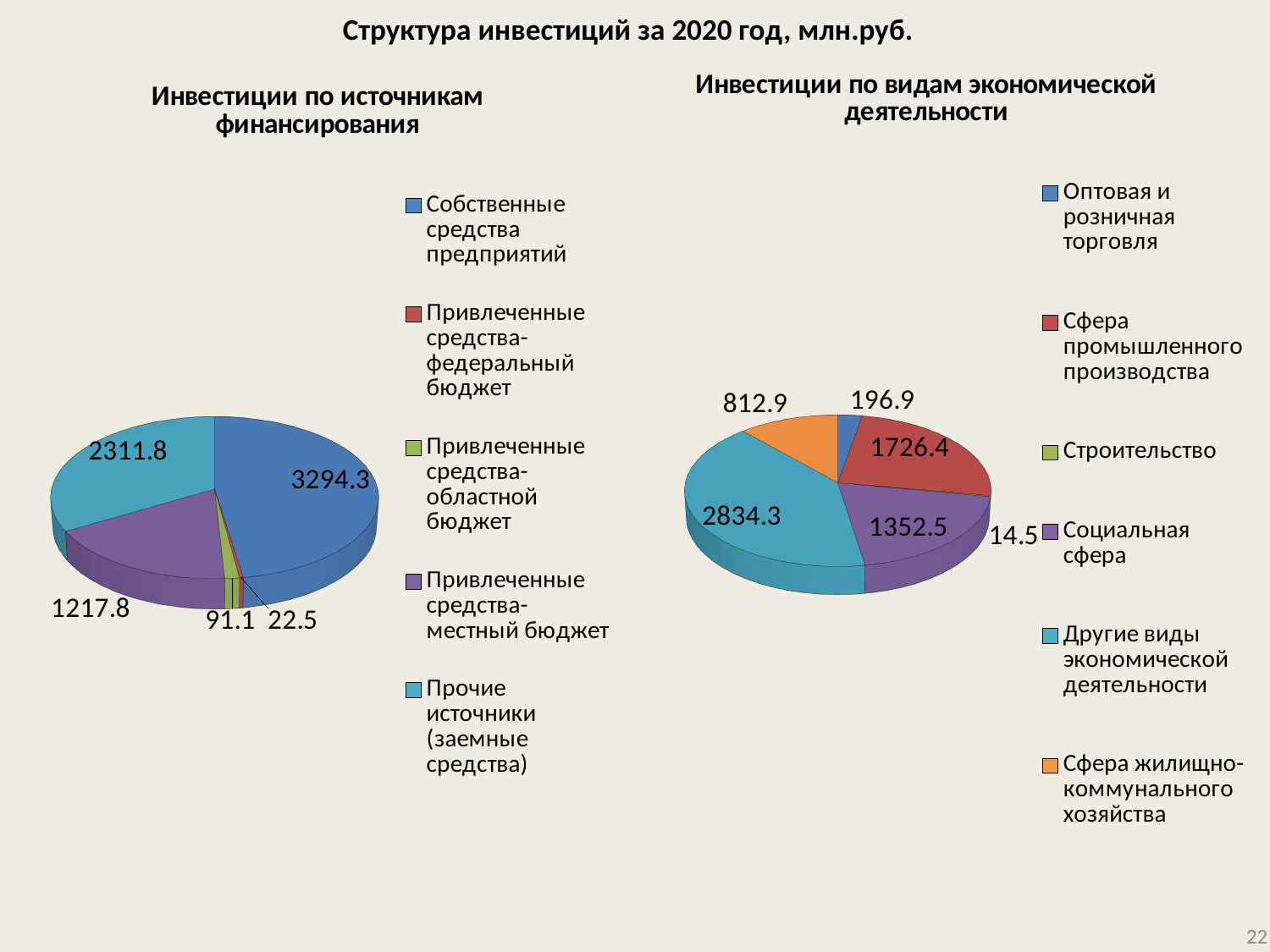
On the left pie chart (Инвестиции по источникам финансирования), what is the value for Привлеченные средства-местный бюджет? 1217.8 On the right pie chart (Инвестиции по видам экономической деятельности), what is the value for Строительство? 14.5 On the right pie chart (Инвестиции по видам экономической деятельности), what is the difference between Другие виды экономической деятельности and Сфера промышленного производства? 1107.9 On the left pie chart (Инвестиции по источникам финансирования), what is the value for Собственные средства предприятий? 3294.3 On the right pie chart (Инвестиции по видам экономической деятельности), how many categories does the legend list? 6 What type of chart is used for both charts on the slide? Pie chart On the left pie chart (Инвестиции по источникам финансирования), which source has the smallest value? Привлеченные средства-федеральный бюджет On the right pie chart (Инвестиции по видам экономической деятельности), which category has the largest value? Другие виды экономической деятельности On the right pie chart (Инвестиции по видам экономической деятельности), what is the value for Сфера промышленного производства? 1726.4 On the left pie chart (Инвестиции по источникам финансирования), how many slices does the pie have? 5 On the left pie chart (Инвестиции по источникам финансирования), what is the difference between Собственные средства предприятий and Прочие источники (заемные средства)? 982.5 On the right pie chart (Инвестиции по видам экономической деятельности), which is larger: Социальная сфера or Сфера жилищно-коммунального хозяйства? Социальная сфера